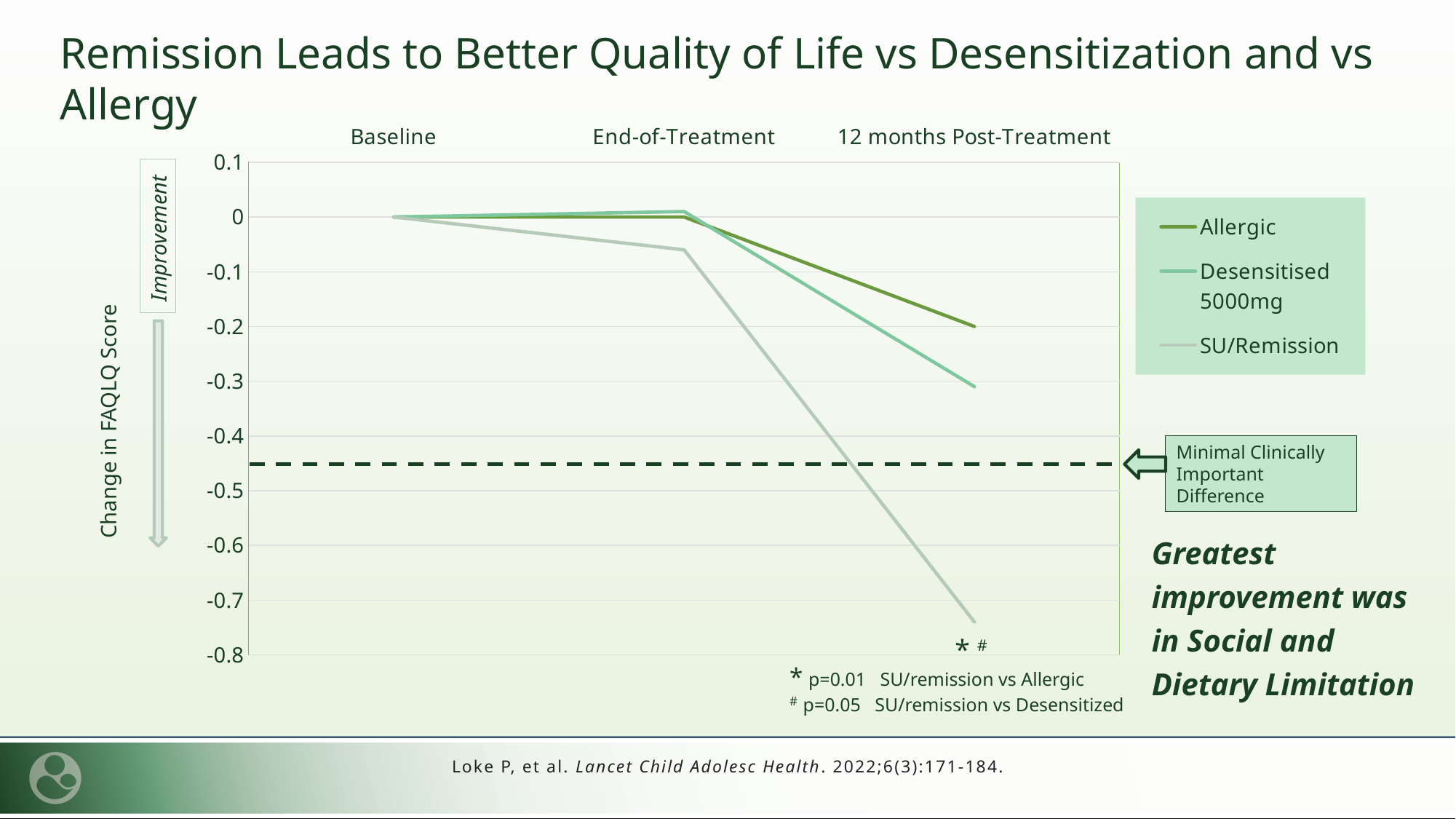
What does the horizontal dashed line on the chart represent? Minimal Clinically Important Difference Is the value for SU/Remission at End-of-Treatment greater or less than -0.1? greater Is the value for SU/Remission at 12 months Post-Treatment greater or less than -0.6? less Which series has the lowest value at 12 months Post-Treatment? SU/Remission What kind of chart is shown on the slide? line chart Which series has the highest value at 12 months Post-Treatment? Allergic Does the SU/Remission line rise or fall from Baseline to 12 months Post-Treatment? fall Is the value for Desensitised 5000mg at 12 months Post-Treatment greater or less than -0.2? less How many series does the legend list? 3 How many time points are plotted along the x axis? 3 What is the value for all three series at Baseline? 0 At 12 months Post-Treatment, which is larger: the value for Allergic or the value for Desensitised 5000mg? Allergic